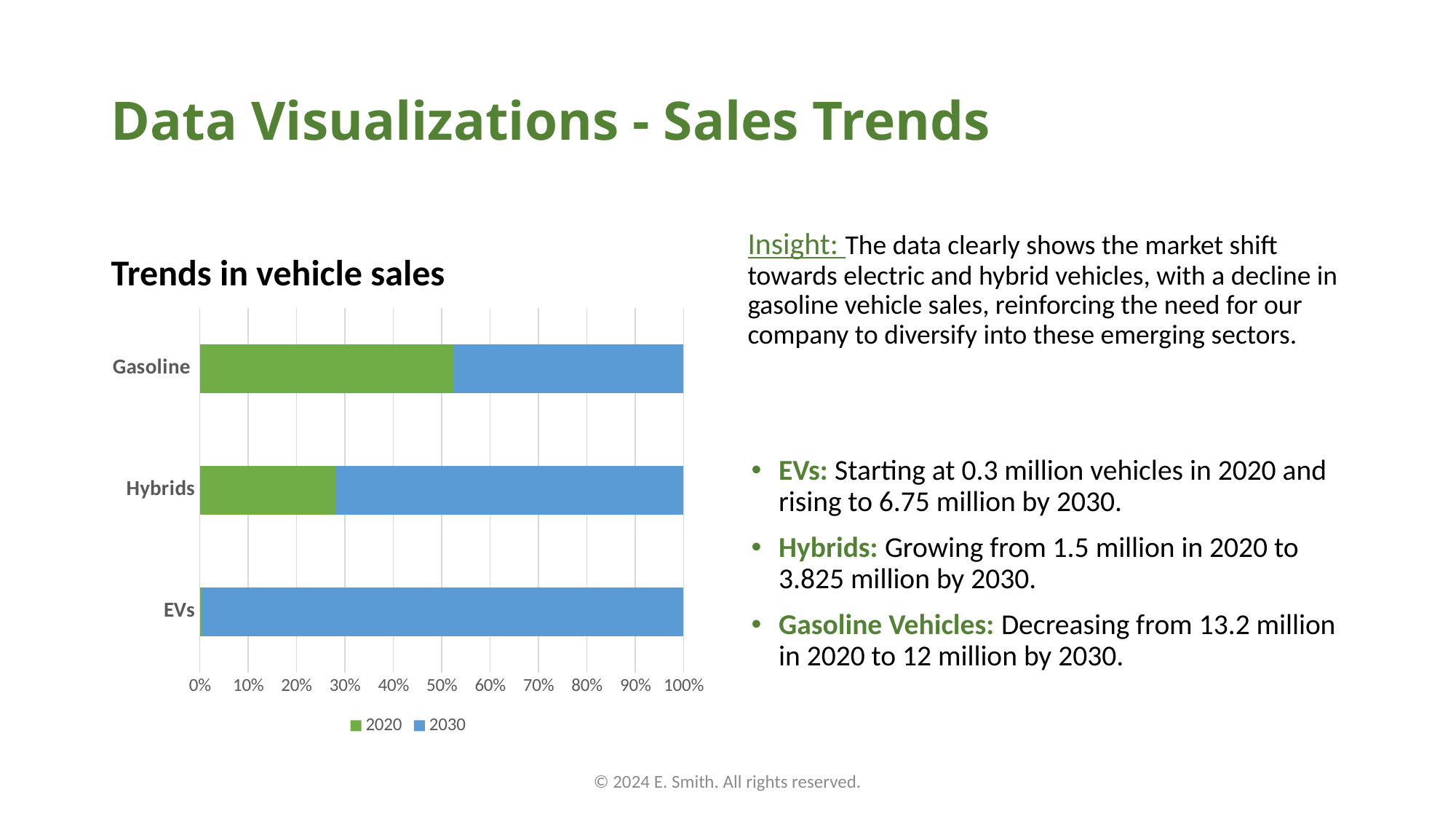
Which category has the smallest 2020 share of its bar? EVs Which series is shown in green in the chart? 2020 What is the title of the chart? Trends in vehicle sales Which category has the largest 2020 share of its bar? Gasoline What kind of chart is shown on the slide? Stacked bar chart Is the 2020 share for EVs greater or less than 10%? less How many series does the chart legend list? 2 How many categories are shown on the chart's vertical axis? 3 What is the total of the stacked bar for Hybrids? 100% Is the 2020 share for Hybrids greater or less than 40%? less Which is larger: the 2020 share for Gasoline or the 2020 share for Hybrids? Gasoline Is the 2020 share for Gasoline greater or less than 40%? greater